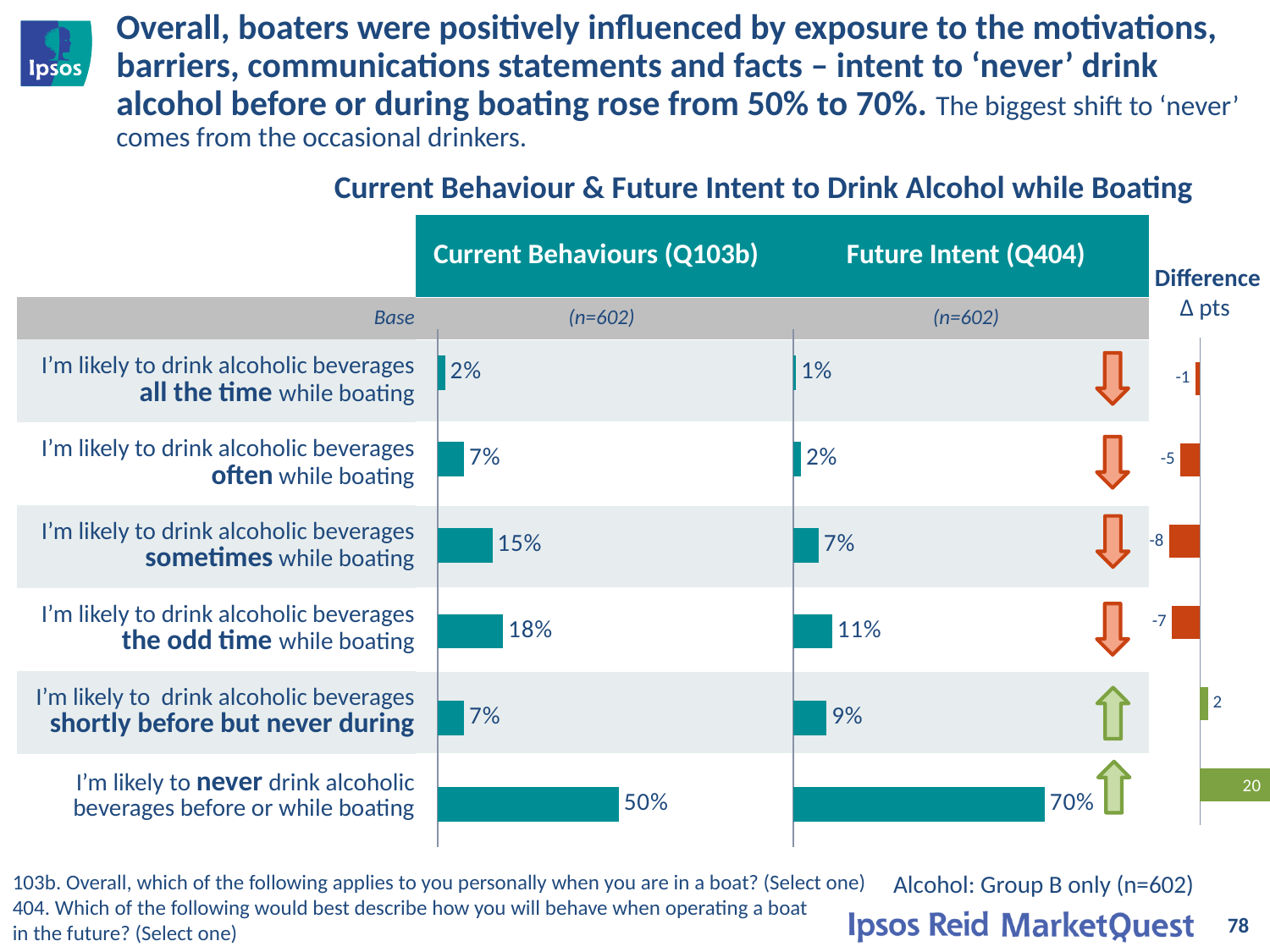
What is the title of the chart on the slide? Current Behaviour & Future Intent to Drink Alcohol while Boating In the Current Behaviours (Q103b) chart, what percentage of boaters say they are likely to never drink alcoholic beverages before or while boating? 50% What is the difference between the Future Intent (Q404) and Current Behaviours (Q103b) values for never drinking alcoholic beverages before or while boating? 20 Which is larger: the Current Behaviours (Q103b) value for drinking often while boating, or the Future Intent (Q404) value for drinking often while boating? Current Behaviours (Q103b) In the Future Intent (Q404) chart, which category has the lowest value? I'm likely to drink alcoholic beverages all the time while boating In the Current Behaviours (Q103b) chart, which category has the highest value? I'm likely to never drink alcoholic beverages before or while boating In the Future Intent (Q404) chart, what percentage of boaters say they are likely to never drink alcoholic beverages before or while boating? 70% What type of chart is used to show the Current Behaviours (Q103b) values? Bar chart In the Future Intent (Q404) chart, what is the value for drinking alcoholic beverages sometimes while boating? 7% How many categories are shown in the Current Behaviours (Q103b) chart? 6 In the Difference (Δ pts) chart, what is the difference shown for drinking alcoholic beverages sometimes while boating? -8 In the Current Behaviours (Q103b) chart, what is the value for drinking alcoholic beverages the odd time while boating? 18%